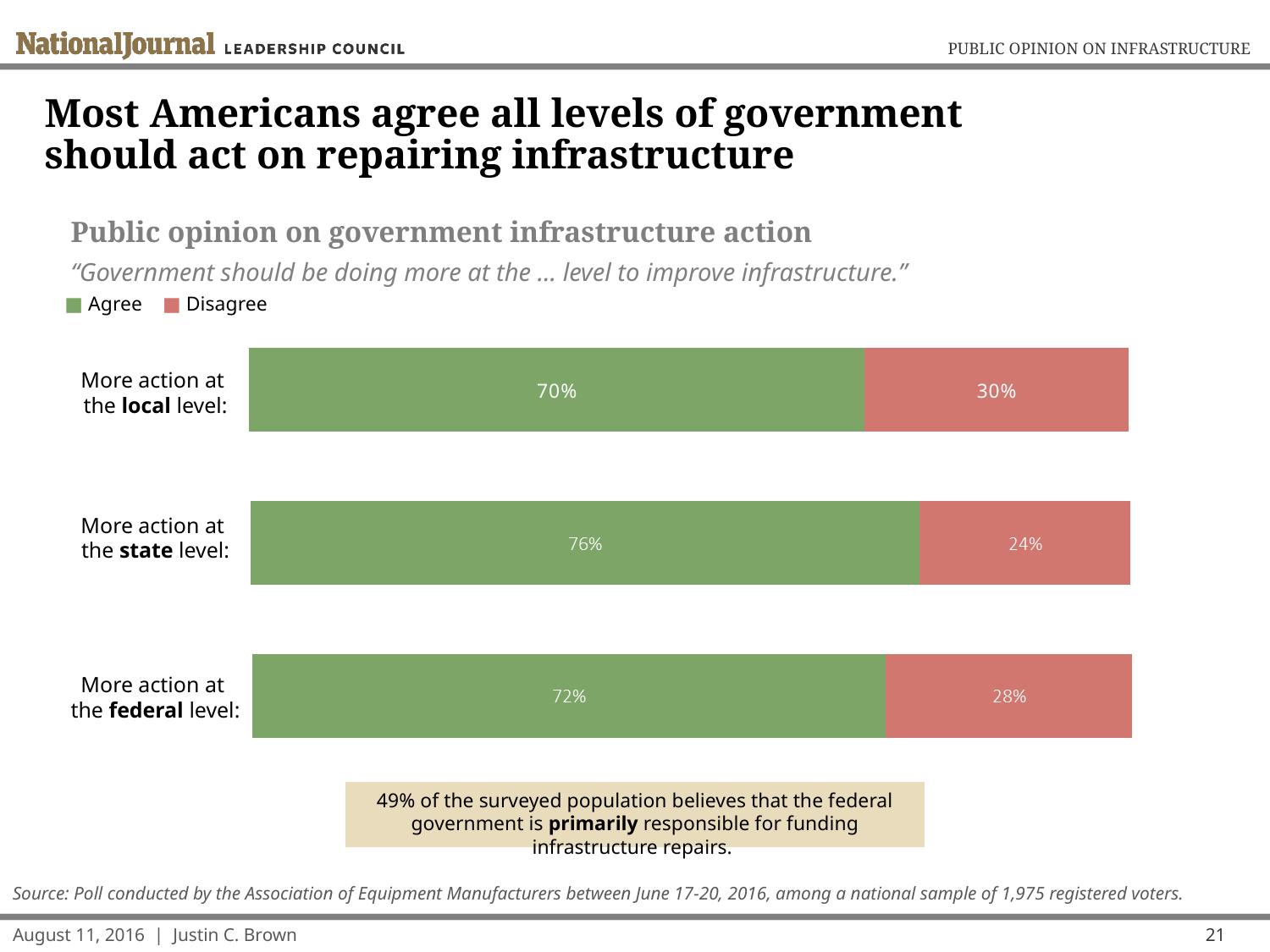
What percentage disagree that government should be doing more at the state level? 24% What is the difference between the Agree percentages for the state level and the local level? 6 percentage points Which colour represents Disagree in the chart? Red What percentage agree that government should be doing more at the federal level? 72% What percentage agree that government should be doing more at the local level? 70% Which level of government has the highest share of respondents agreeing that more action is needed? State What is the total of the Agree and Disagree values for the federal level bar? 100% Is the Disagree share larger for the local level or the federal level? Local Which level of government has the lowest share of respondents agreeing that more action is needed? Local What kind of chart is shown on the slide? Stacked bar chart How many series does the legend list? 2 How many levels of government are shown in the chart? 3